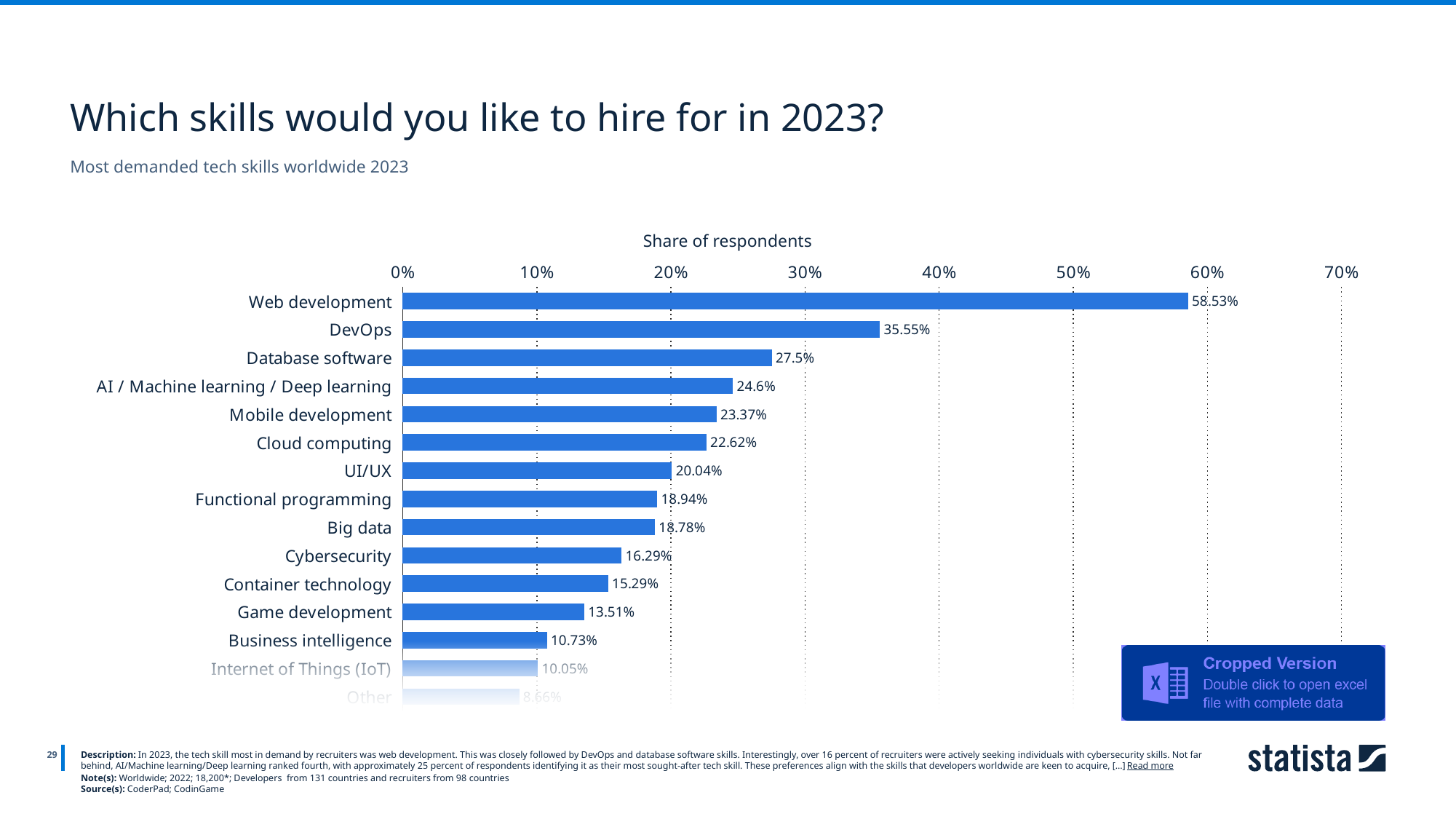
What share of respondents selected Cloud computing? 22.62% Which category has the lowest value on the chart? Other How many skill categories are shown on the chart? 15 What type of chart is shown on the slide? Bar chart What is the label of the horizontal axis? Share of respondents Is the value for Game development greater or less than 20%? less What is the difference in percentage points between Web development and DevOps? 22.98 Which skill has the highest share of respondents? Web development What is the difference in percentage points between Cybersecurity and Container technology? 1.00 What is the value shown for Cybersecurity? 16.29% Which has a larger share of respondents, DevOps or Database software? DevOps What share of respondents selected Web development? 58.53%